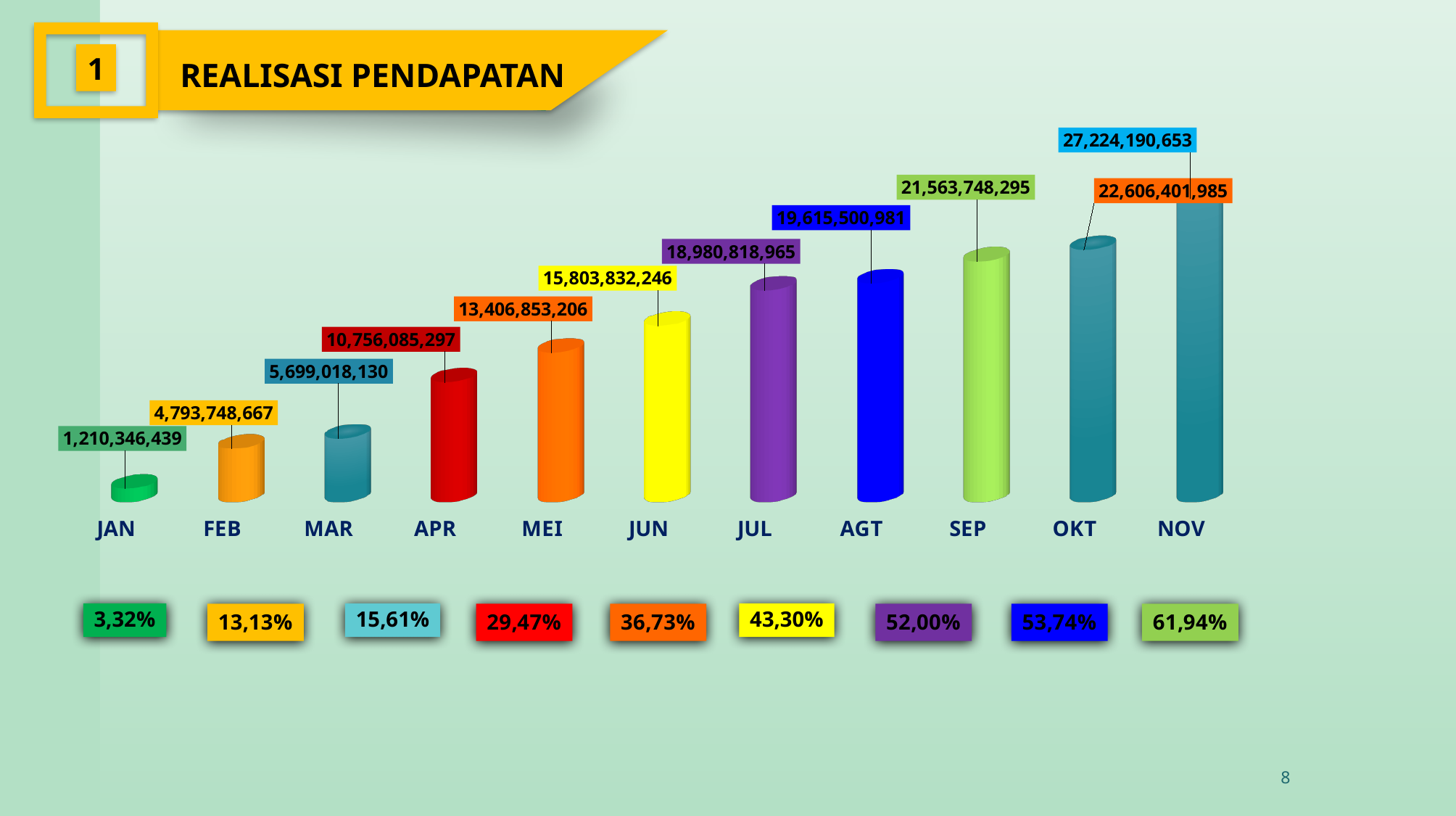
Which month has the highest value? NOV What is the difference between the values for NOV and OKT? 4,617,788,668 Do the values rise or fall from JAN to NOV? rise What is the value for SEP? 21,563,748,295 Which month has the lowest value? JAN What is the value for OKT? 22,606,401,985 How many months are shown on the chart? 11 What is the difference between the values for FEB and JAN? 3,583,402,228 What is the value for JAN? 1,210,346,439 What is the value for MEI? 13,406,853,206 Which is larger, the value for APR or the value for MAR? APR What kind of chart is shown on the slide? bar chart